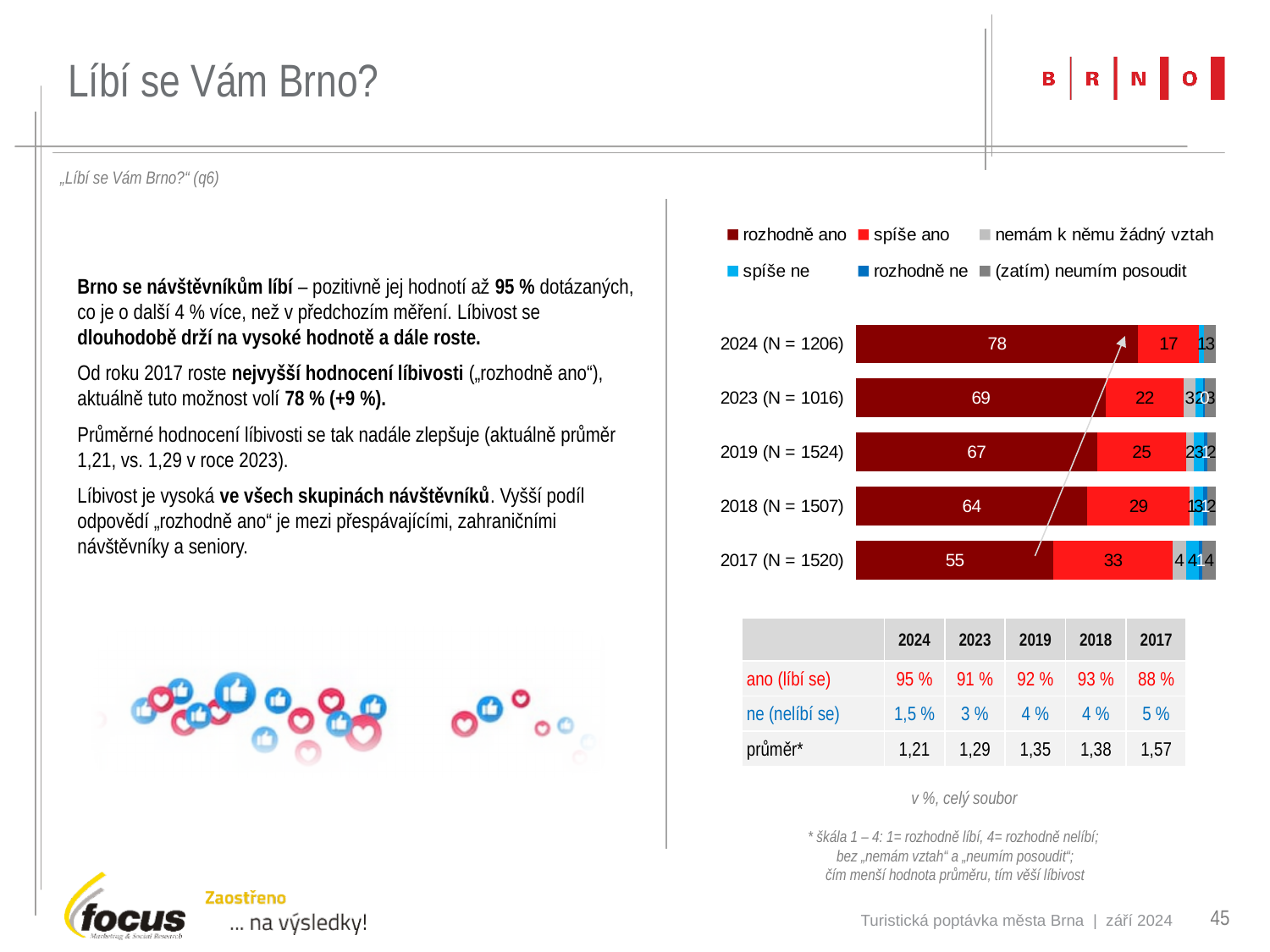
Which year has the lowest value for "spíše ano"? 2024 (N = 1206) What is the value of "spíše ano" for 2018 (N = 1507)? 29 What is the value of "rozhodně ano" for 2019 (N = 1524)? 67 How many series does the chart legend list? 6 What type of chart is shown on the slide? stacked bar chart What is the difference between the "rozhodně ano" values for 2024 and 2023? 9 Which is larger: "spíše ano" for 2023 or "spíše ano" for 2019? 2019 How many year categories are plotted in the chart? 5 What is the value of "spíše ano" for 2017 (N = 1520)? 33 Does the "rozhodně ano" value rise or fall from 2017 to 2024 along the chart? rise What is the value of "rozhodně ano" for 2024 (N = 1206)? 78 Which year has the highest value for "rozhodně ano"? 2024 (N = 1206)